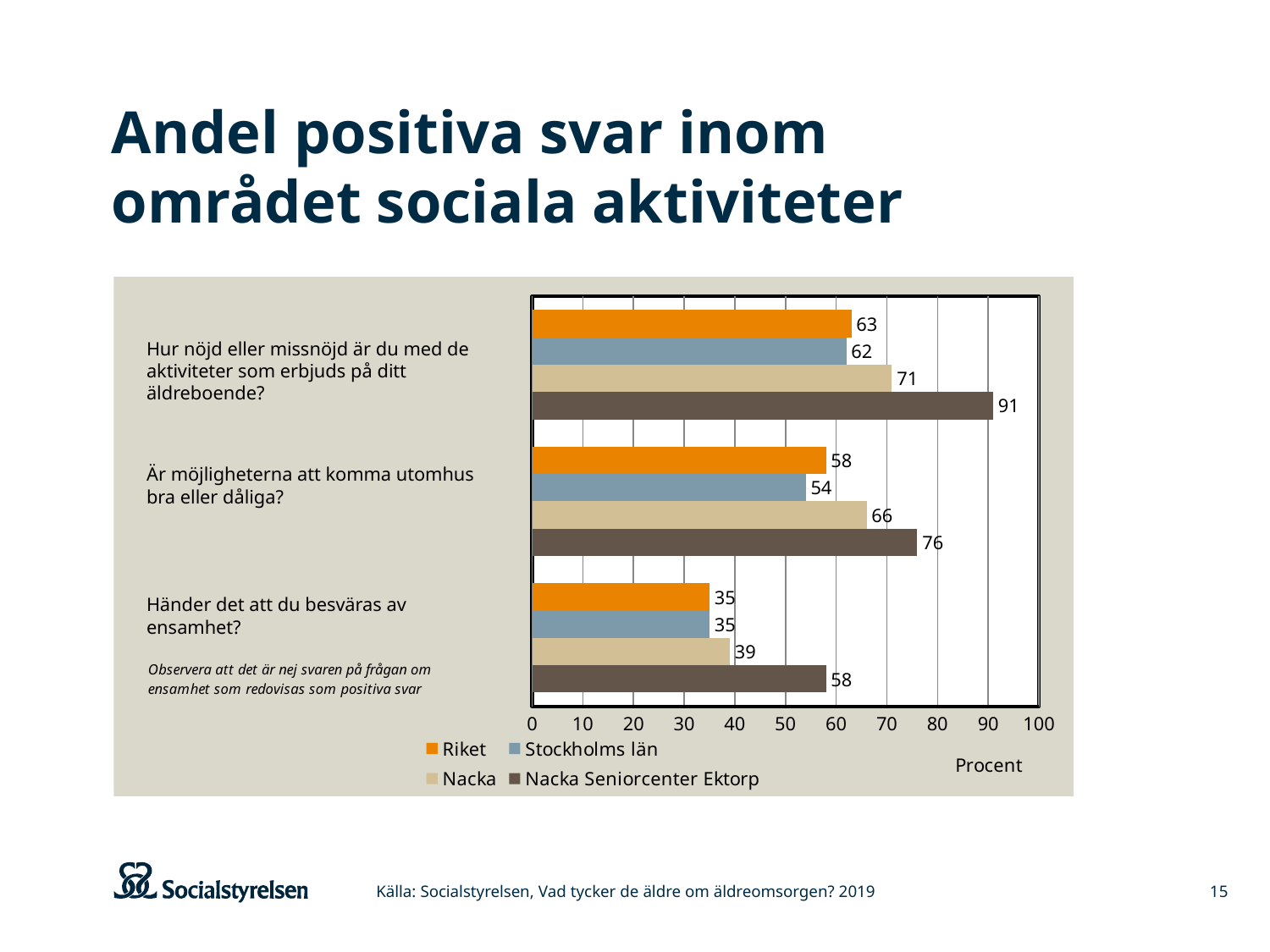
What is the value for Nacka on the question "Händer det att du besväras av ensamhet?"? 39 Which series has the lowest value on the question "Hur nöjd eller missnöjd är du med de aktiviteter som erbjuds på ditt äldreboende?"? Stockholms län What is the difference between Nacka Seniorcenter Ektorp and Riket on the question "Hur nöjd eller missnöjd är du med de aktiviteter som erbjuds på ditt äldreboende?"? 28 What is the label of the horizontal axis? Procent What is the value for Stockholms län on the question "Är möjligheterna att komma utomhus bra eller dåliga?"? 54 Which is larger on the question "Händer det att du besväras av ensamhet?": Nacka or Nacka Seniorcenter Ektorp? Nacka Seniorcenter Ektorp What is the difference between Nacka and Riket on the question "Är möjligheterna att komma utomhus bra eller dåliga?"? 8 What kind of chart is shown on the slide? Bar chart What is the value for Nacka Seniorcenter Ektorp on the question "Hur nöjd eller missnöjd är du med de aktiviteter som erbjuds på ditt äldreboende?"? 91 How many questions (categories) are shown on the chart? 3 How many series does the legend list? 4 Which series has the highest value on the question "Är möjligheterna att komma utomhus bra eller dåliga?"? Nacka Seniorcenter Ektorp